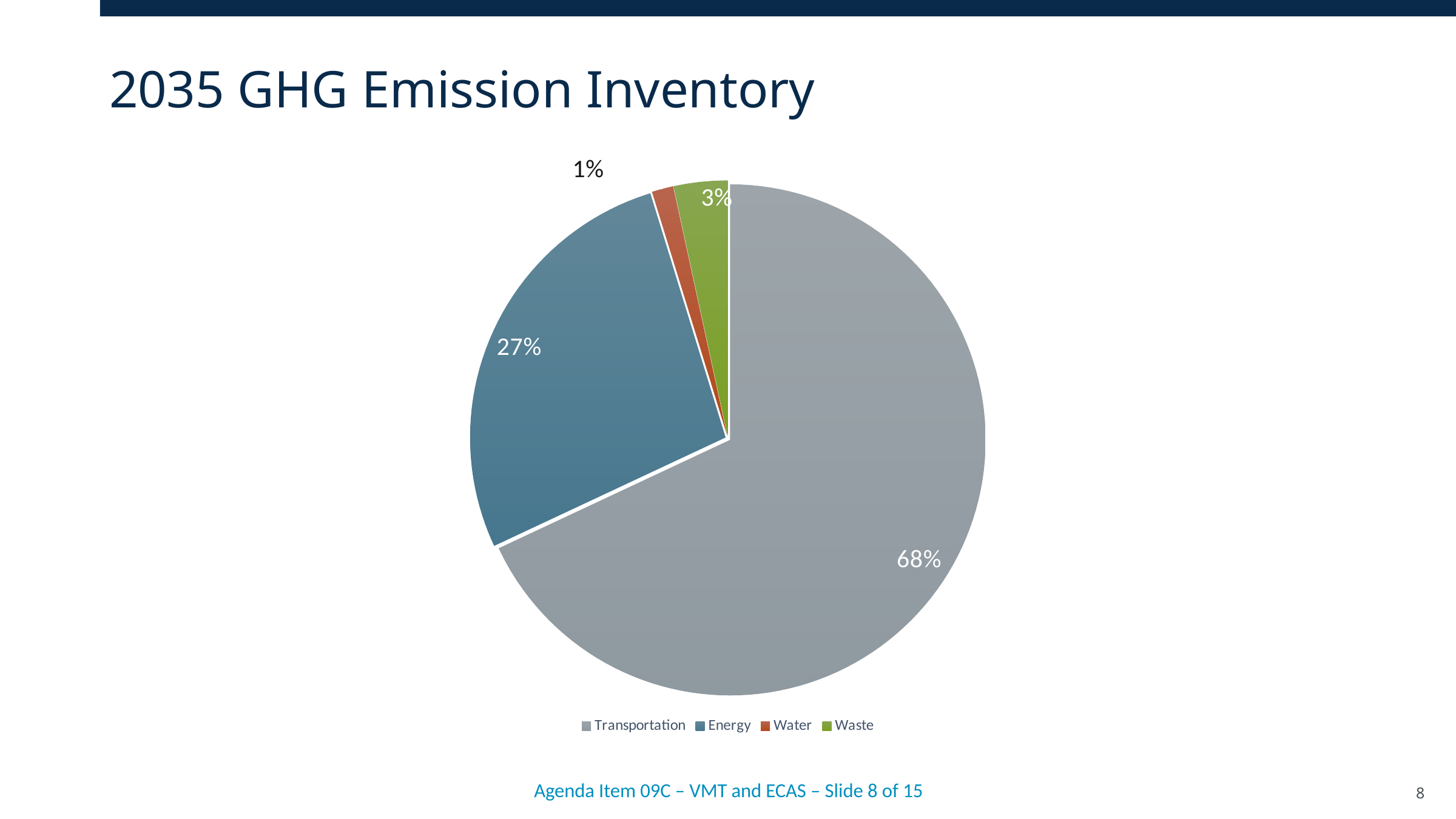
What share of 2035 GHG emissions comes from Water? 1% Which category has the smallest share of 2035 GHG emissions? Water What type of chart is shown on the slide? Pie chart Which has a larger share, Waste or Water? Waste Which category has the largest share of 2035 GHG emissions? Transportation What is the combined share of Water and Waste? 4% What share of 2035 GHG emissions comes from Energy? 27% What share of 2035 GHG emissions comes from Transportation? 68% What colour represents Energy in the pie chart? Blue What is the difference in percentage points between the Transportation and Energy shares? 41 What share of 2035 GHG emissions comes from Waste? 3% How many categories are shown in the pie chart? 4